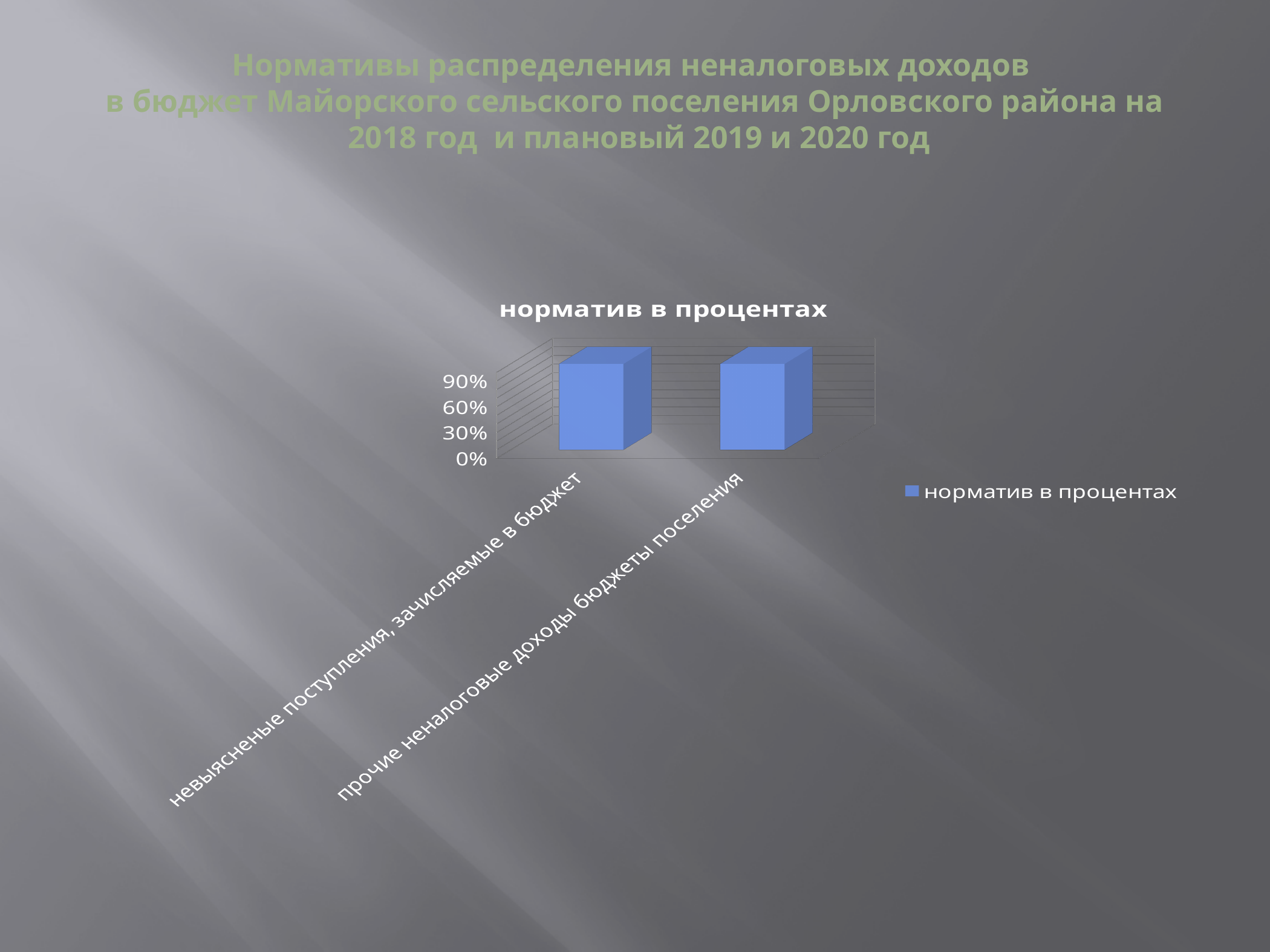
How many series does the chart legend list? 1 Is the value for 'прочие неналоговые доходы бюджеты поселения' greater or less than 60%? greater Is the value for 'прочие неналоговые доходы бюджеты поселения' greater or less than 90%? greater What is the title of the chart? норматив в процентах What series name is shown in the chart legend? норматив в процентах How many categories are plotted in the chart? 2 What kind of chart is shown on the slide? bar chart Is the value for 'невыясненные поступления, зачисляемые в бюджет' greater or less than 60%? greater